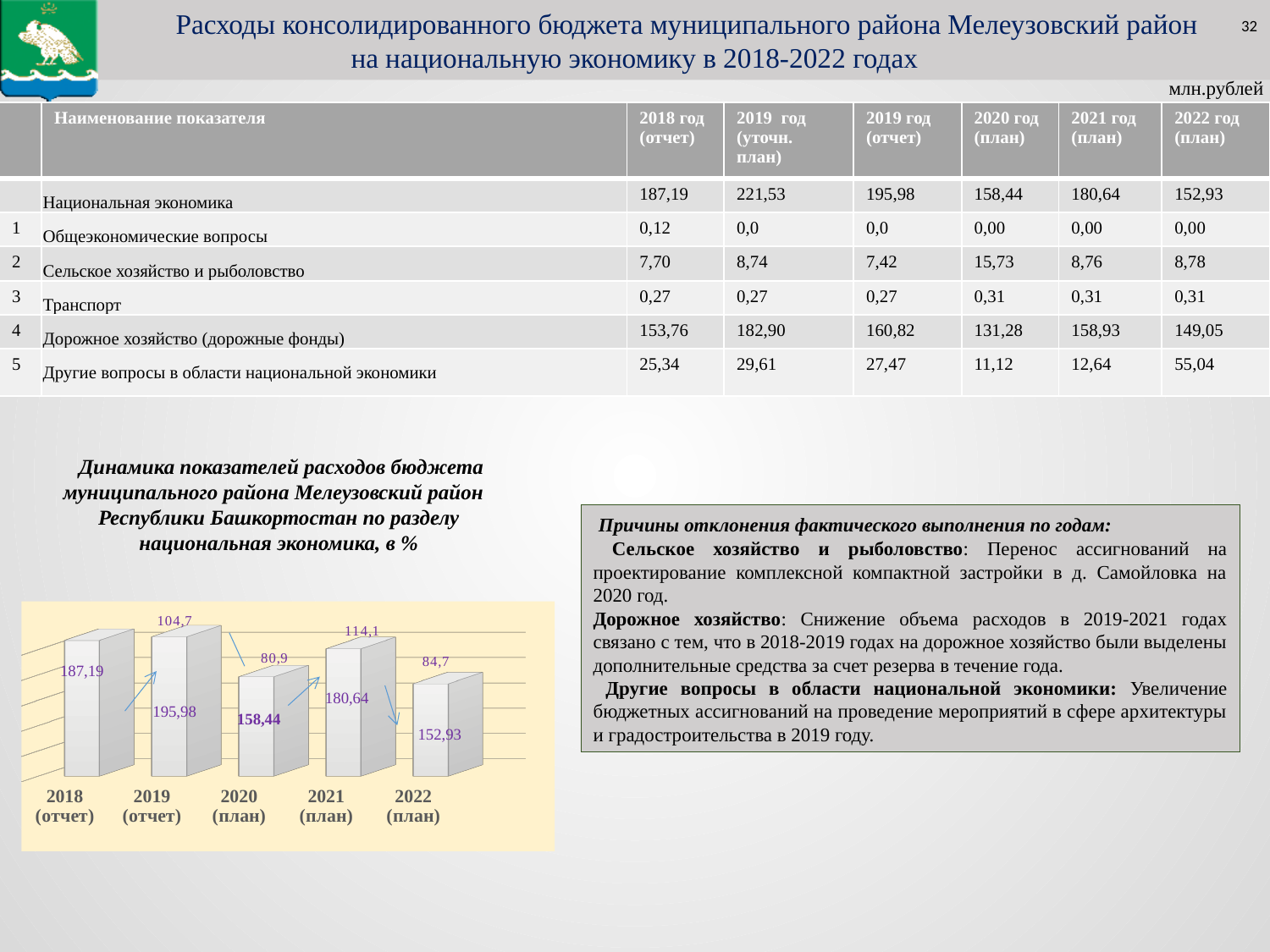
In the chart at the bottom left, which year has the lowest value? 2022 (план) In the chart at the bottom left, what is the value for 2020 (план)? 158,44 In the chart at the bottom left, what is the value for 2018 (отчет)? 187,19 In the chart at the bottom left, what is the value for 2019 (отчет)? 195,98 In the chart at the bottom left, which year has the highest value? 2019 (отчет) In the chart at the bottom left, which is larger: the value for 2021 (план) or the value for 2020 (план)? 2021 (план) How many bars (years) are plotted in the chart at the bottom left of the slide? 5 In the chart at the bottom left, what is the difference between the values for 2019 (отчет) and 2018 (отчет)? 8,79 In the chart at the bottom left, what is the value for 2022 (план)? 152,93 What type of chart is shown at the bottom left of the slide? bar chart In the chart at the bottom left, what percentage label is shown between the 2020 (план) and 2021 (план) bars? 114,1 In the chart at the bottom left, does the value fall or rise from 2021 (план) to 2022 (план)? fall